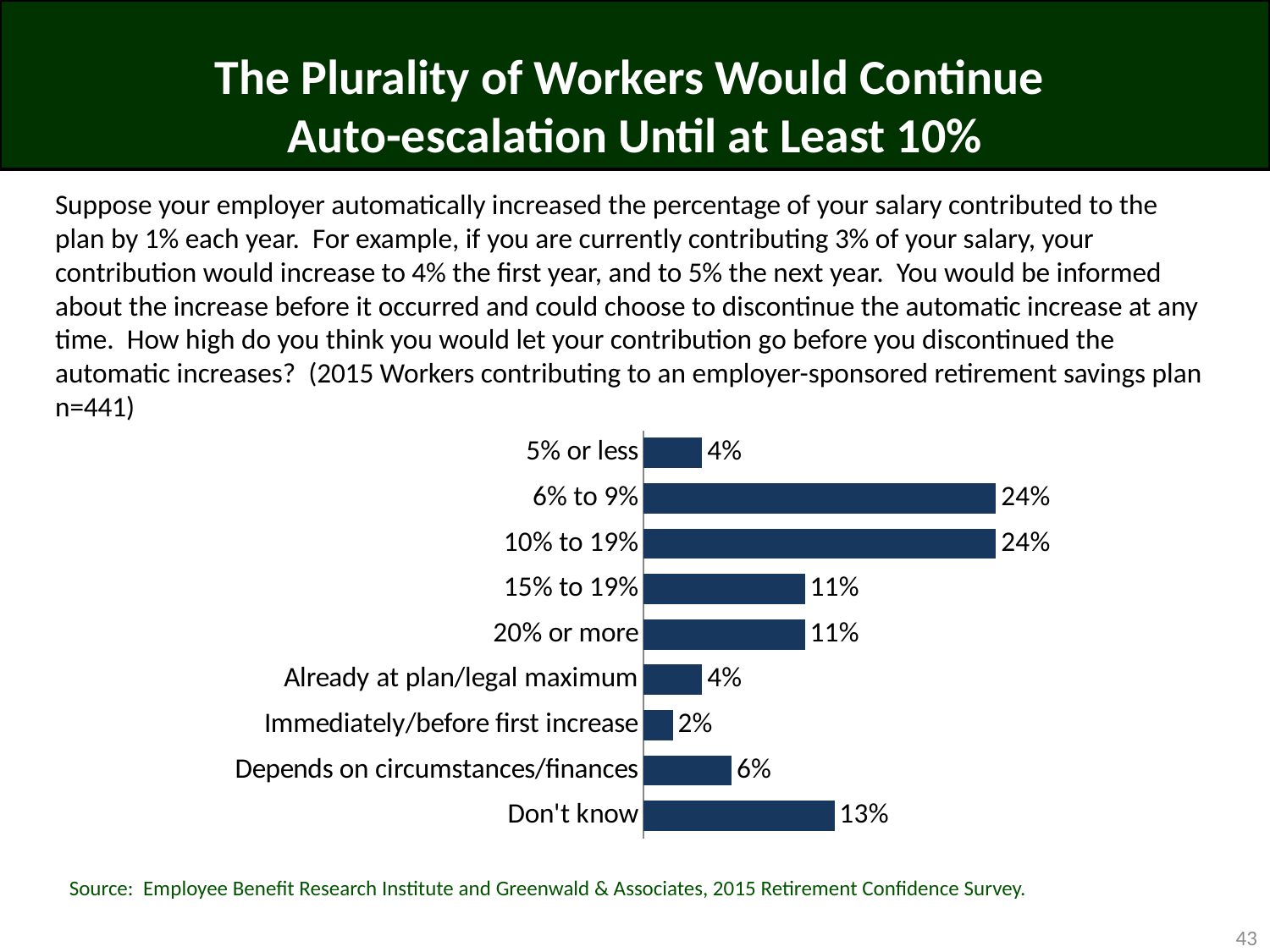
Which category has the lowest value in the chart? Immediately/before first increase What is the sample size (n) stated for the survey question on the slide? 441 What is the difference between the value for "Don't know" and the value for "Immediately/before first increase"? 11% What is the difference between the value for "10% to 19%" and the value for "15% to 19%"? 13% What is the value for "Already at plan/legal maximum"? 4% Which is larger, the value for "Don't know" or the value for "20% or more"? Don't know What is the value shown for "Don't know"? 13% How many categories are shown in the chart? 9 What kind of chart is shown on the slide? Bar chart What is the highest value shown in the chart? 24% What percentage of workers answered "Depends on circumstances/finances"? 6% What percentage of workers said they would let their contribution go to 6% to 9% before discontinuing automatic increases? 24%